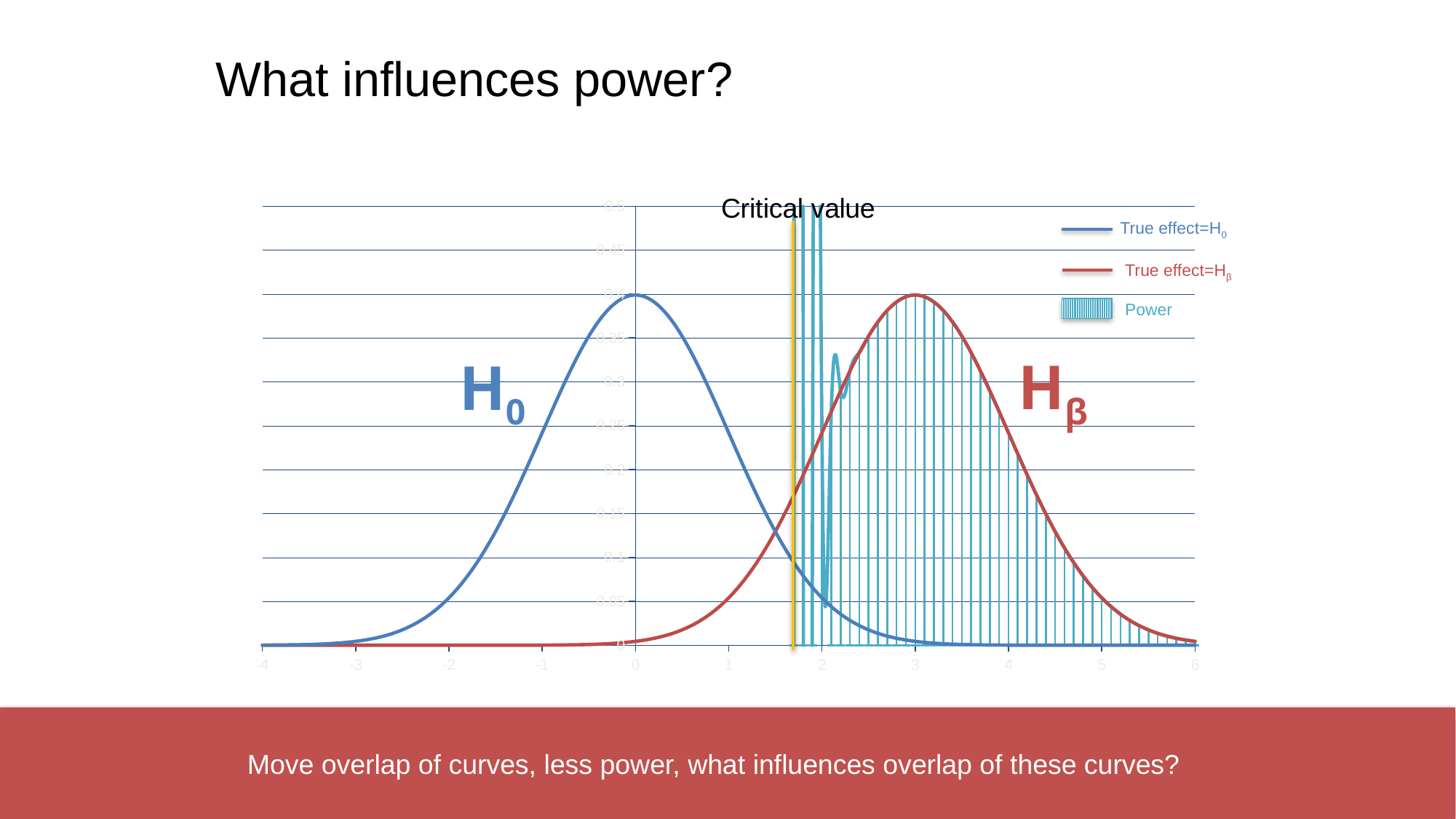
At which x-axis value does the red Hβ curve reach its peak? 3 Is the critical value on the x axis greater or less than 1? greater What is the title of the slide containing the chart? What influences power? What label is given to the vertical yellow line on the chart? Critical value How many entries does the chart legend list? 3 At x = 4, which curve is higher, the blue H0 curve or the red Hβ curve? the red Hβ curve Does the red Hβ curve rise or fall as x increases from 3 to 6? fall At which x-axis value does the blue H0 curve reach its peak? 0 At x = 0, which curve is higher, the blue H0 curve or the red Hβ curve? the blue H0 curve Is the critical value on the x axis greater or less than 2? less What is the lowest value shown on the x axis? -4 What kind of chart is shown on the slide? line chart